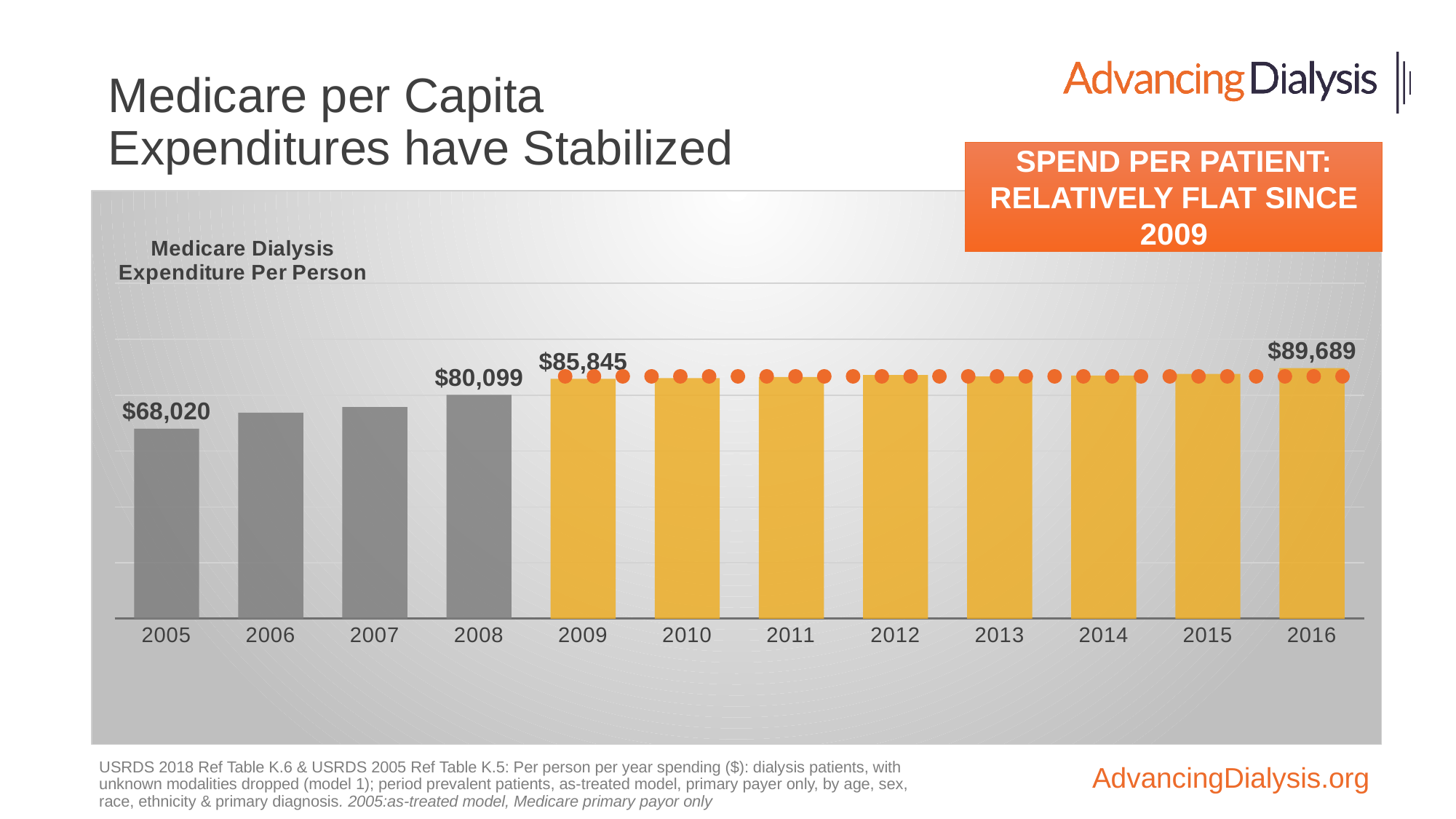
What is the Medicare dialysis expenditure per person for 2009? $85,845 What is the Medicare dialysis expenditure per person for 2008? $80,099 Which year has the lowest Medicare dialysis expenditure per person? 2005 Which year has the larger expenditure per person, 2008 or 2009? 2009 What is the Medicare dialysis expenditure per person for 2016? $89,689 What is the Medicare dialysis expenditure per person for 2005? $68,020 What type of chart is shown on the slide? bar chart What is the difference between the 2009 and 2008 expenditure per person values? $5,746 Which year has the highest Medicare dialysis expenditure per person? 2016 What is the difference between the 2016 and 2005 expenditure per person values? $21,669 Do the expenditure values rise or fall from 2005 to 2008? rise How many years are shown on the x axis of the chart? 12